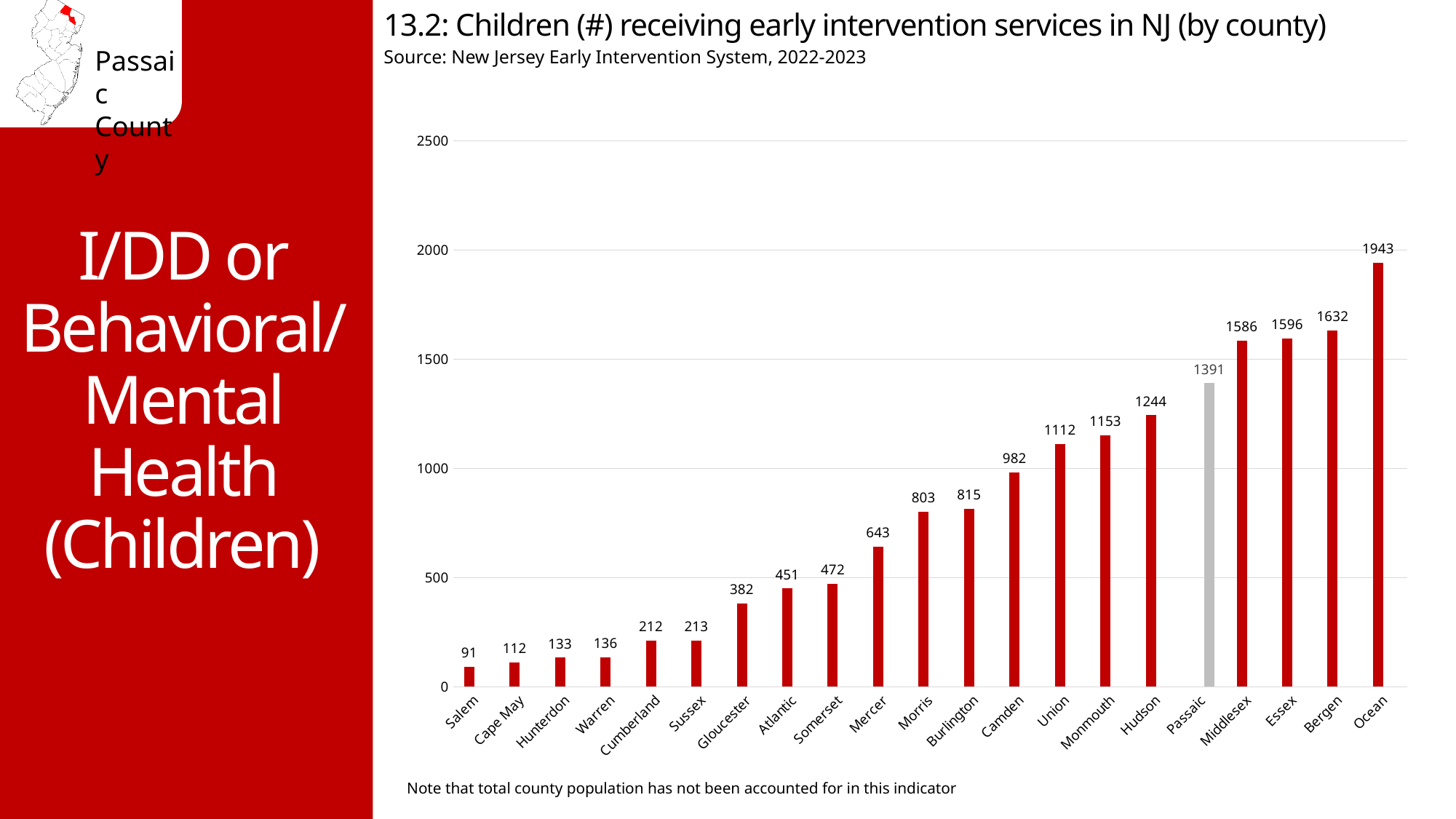
Which has a larger value, Camden or Morris? Camden What is the difference between the values for Bergen and Essex? 36 Which county has the lowest number of children receiving early intervention services? Salem How many counties are shown on the chart? 21 How many children are receiving early intervention services in Passaic County? 1391 Which county has the highest number of children receiving early intervention services? Ocean Is the value for Union greater or less than 1000? greater Which county's bar is shown in gray rather than red? Passaic What is the value shown for Gloucester? 382 What is the difference between the values for Ocean and Passaic? 552 What is the value shown for Hudson? 1244 What kind of chart is shown on the slide? Bar chart